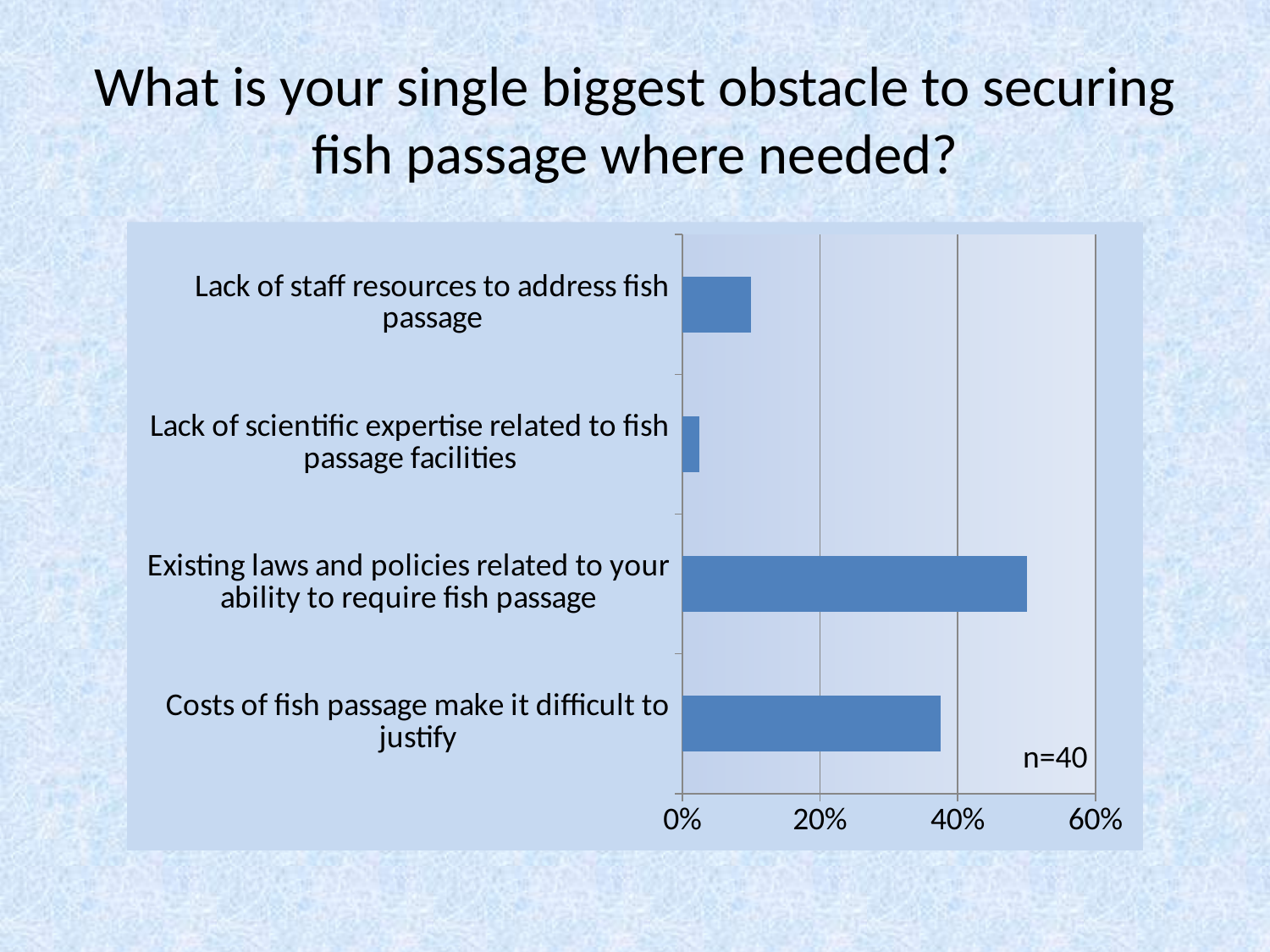
Which obstacle has the lowest value in the chart? Lack of scientific expertise related to fish passage facilities Which is larger: the value for "Existing laws and policies related to your ability to require fish passage" or the value for "Costs of fish passage make it difficult to justify"? Existing laws and policies related to your ability to require fish passage Is the value for "Lack of staff resources to address fish passage" greater or less than 20%? less What kind of chart is shown on the slide? bar chart Is the value for "Costs of fish passage make it difficult to justify" greater or less than 20%? greater Which is larger: the value for "Lack of staff resources to address fish passage" or the value for "Lack of scientific expertise related to fish passage facilities"? Lack of staff resources to address fish passage Is the value for "Costs of fish passage make it difficult to justify" greater or less than 40%? less Which obstacle has the highest value in the chart? Existing laws and policies related to your ability to require fish passage What is the highest value shown on the horizontal axis of the chart? 60% How many obstacle categories are plotted in the chart? 4 What sample size is noted on the chart? n=40